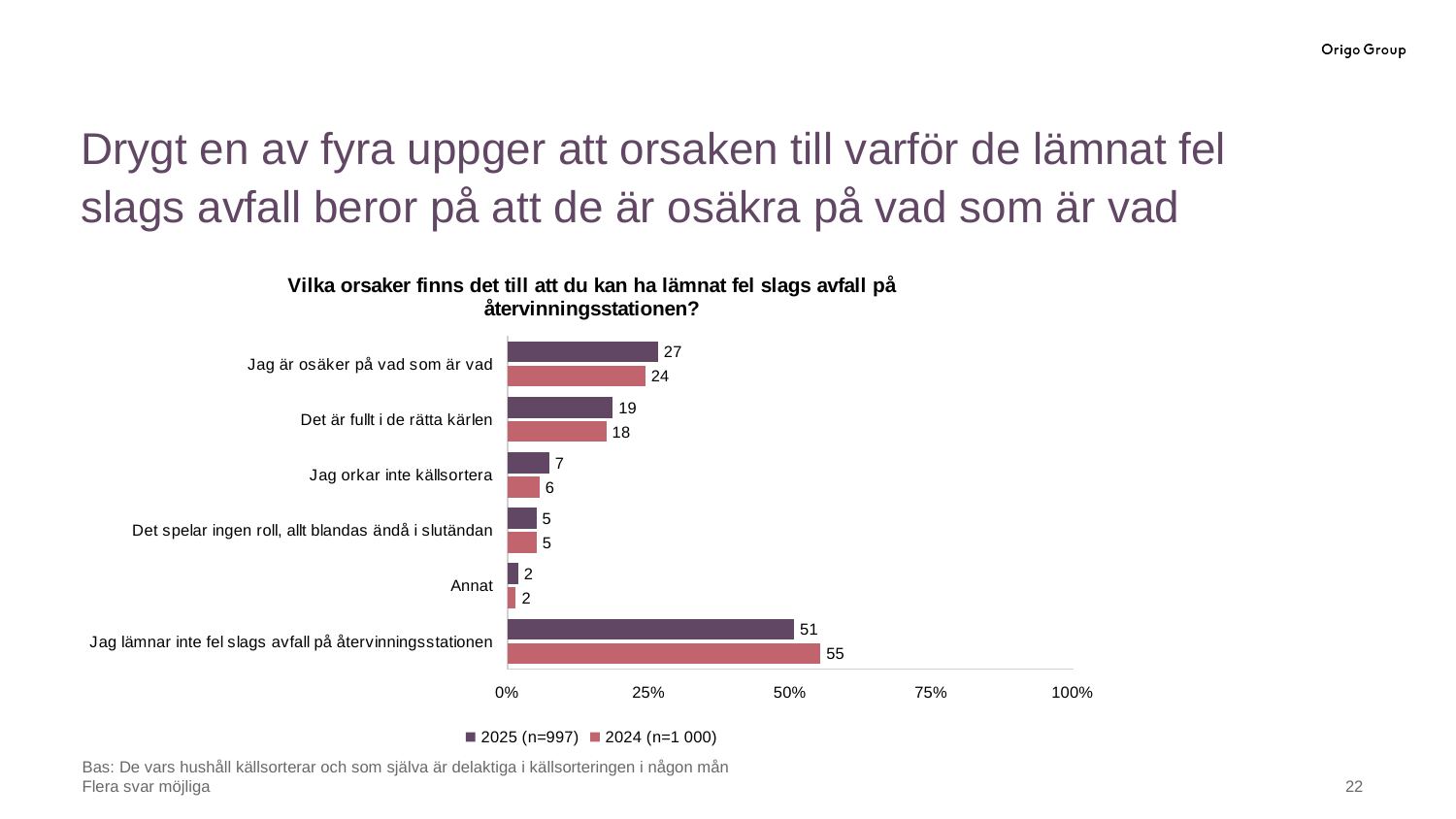
What is the 2025 value for "Jag är osäker på vad som är vad"? 27 For "Jag lämnar inte fel slags avfall på återvinningsstationen", which year has the larger value, 2025 or 2024? 2024 What are the two series listed in the legend? 2025 (n=997) and 2024 (n=1 000) How many categories are shown on the chart? 6 What kind of chart is shown on the slide? Bar chart Is the 2025 value for "Jag lämnar inte fel slags avfall på återvinningsstationen" greater or less than 25%? greater What is the 2024 value for "Jag lämnar inte fel slags avfall på återvinningsstationen"? 55 Which category has the highest 2025 value? Jag lämnar inte fel slags avfall på återvinningsstationen What is the 2024 value for "Det är fullt i de rätta kärlen"? 18 What is the difference between the 2025 and 2024 values for "Jag är osäker på vad som är vad"? 3 How many series does the legend list? 2 Which category has the lowest 2024 value? Annat